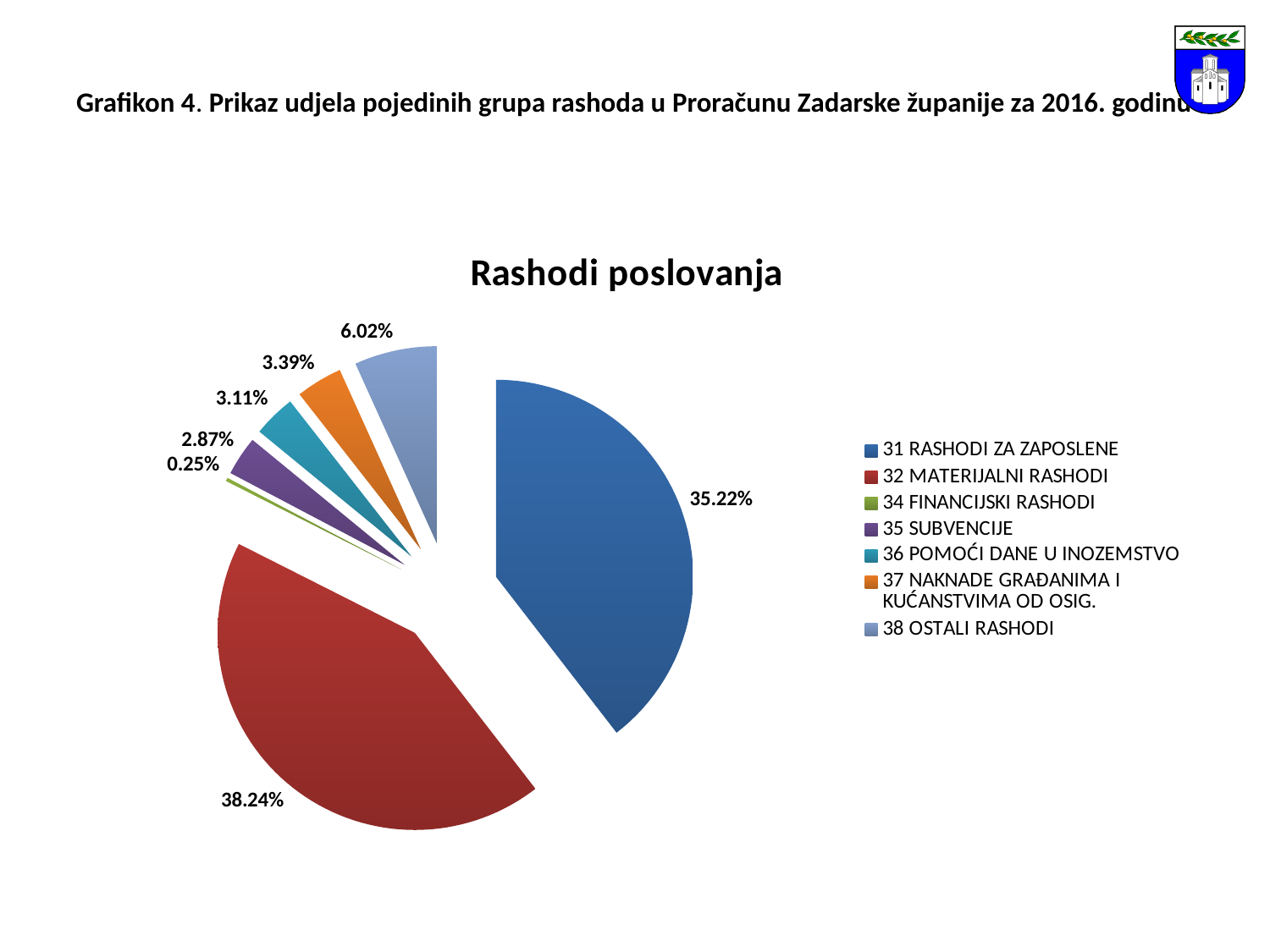
What share of the pie is 32 MATERIJALNI RASHODI? 38.24% What is the value shown for 34 FINANCIJSKI RASHODI? 0.25% What share of the pie is 31 RASHODI ZA ZAPOSLENE? 35.22% What is the title of the chart? Rashodi poslovanja What type of chart is shown on the slide? Pie chart What colour is the slice for 37 NAKNADE GRAĐANIMA I KUĆANSTVIMA OD OSIG.? Orange How many slices does the pie chart have? 7 Which is larger, the share for 36 POMOĆI DANE U INOZEMSTVO or the share for 35 SUBVENCIJE? 36 POMOĆI DANE U INOZEMSTVO Which category has the smallest share of the pie? 34 FINANCIJSKI RASHODI Which category has the largest share of the pie? 32 MATERIJALNI RASHODI What is the difference between the shares of 32 MATERIJALNI RASHODI and 31 RASHODI ZA ZAPOSLENE? 3.02% What is the value shown for 38 OSTALI RASHODI? 6.02%